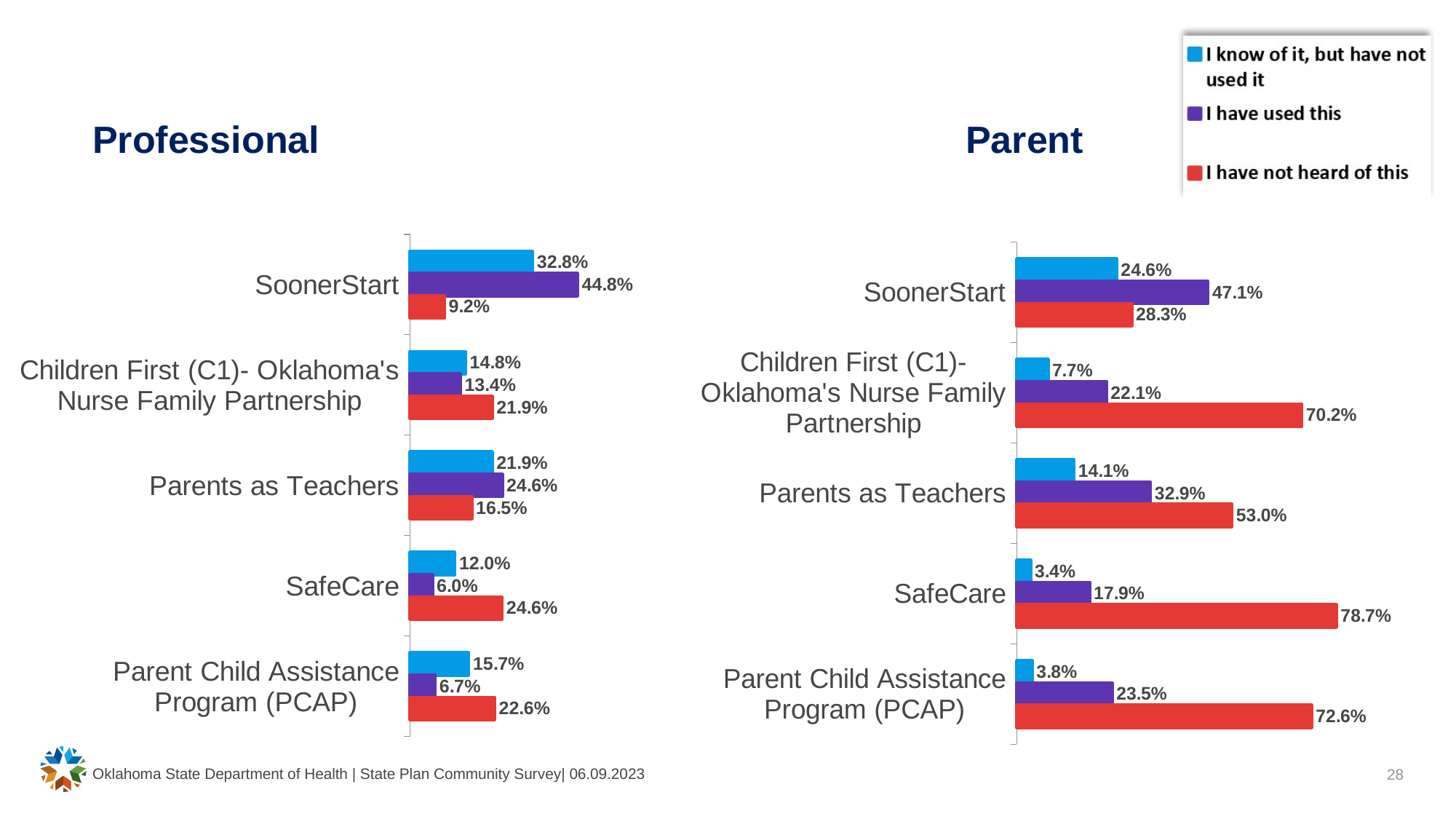
What type of chart is the Parent chart? Bar chart Which colour represents 'I have not heard of this' in the legend? Red How many series does the legend list? 3 In the Parent chart, what is the value for 'I know of it, but have not used it' for Parent Child Assistance Program (PCAP)? 3.8% In the Professional chart, what percentage of respondents said 'I have used this' for SoonerStart? 44.8% In the Parent chart, which program has the lowest 'I have used this' value? SafeCare In the Parent chart, what is the difference between the 'I have not heard of this' values for SafeCare and SoonerStart? 50.4% In the Professional chart, which is larger for Parents as Teachers: 'I have used this' or 'I know of it, but have not used it'? I have used this In the Parent chart, what percentage of respondents said 'I have not heard of this' for SafeCare? 78.7% In the Professional chart, what is the difference between the 'I have used this' values for SoonerStart and SafeCare? 38.8% In the Professional chart, which program has the highest 'I have not heard of this' value? SafeCare How many programs are shown in the Professional chart? 5